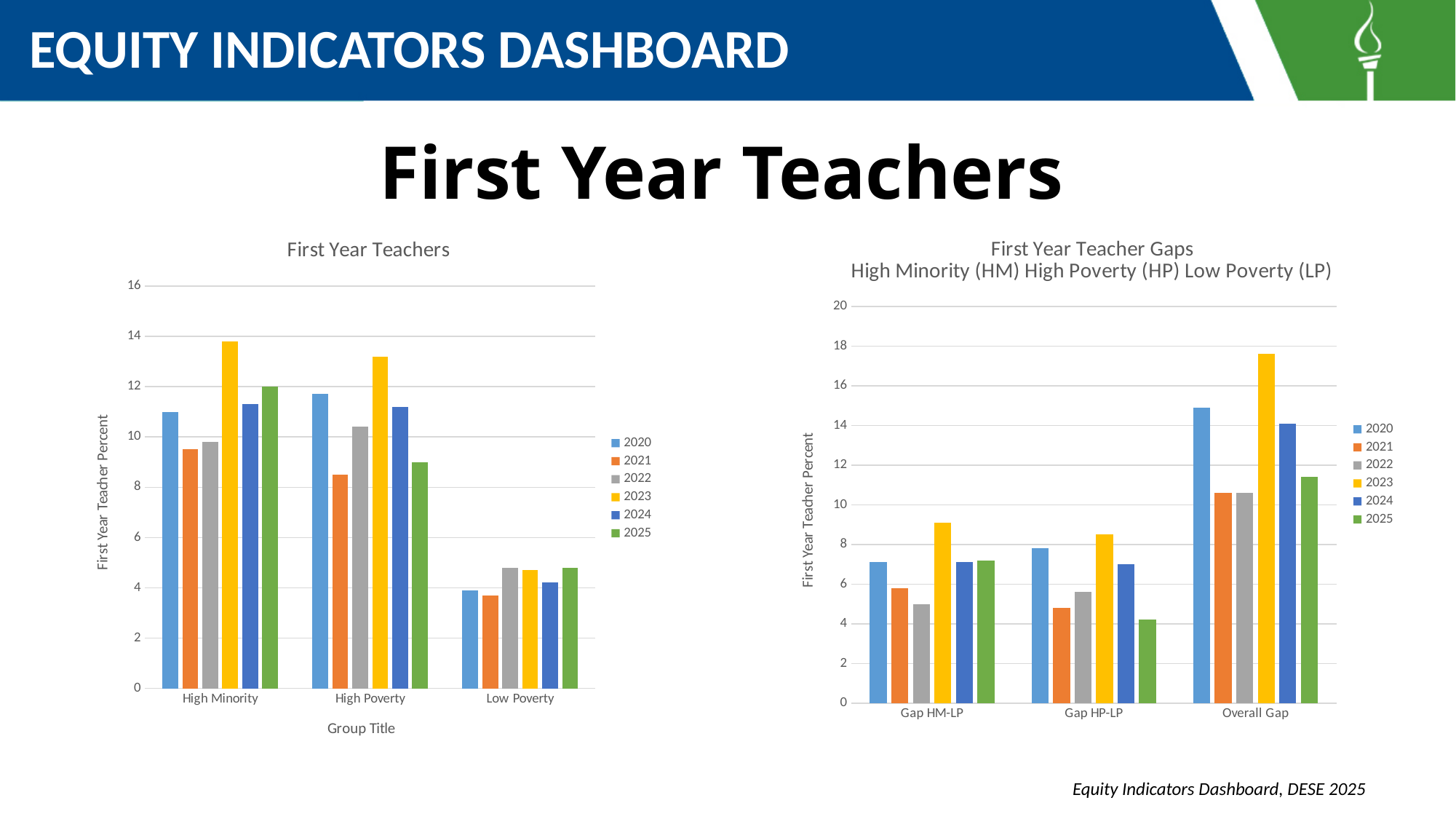
In the 'First Year Teacher Gaps' chart on the right, is the 2023 value for Overall Gap greater or less than 16? greater In the 'First Year Teacher Gaps' chart on the right, which year has the lowest bar for Gap HM-LP? 2022 What kind of chart is the 'First Year Teachers' chart on the left? bar chart In the 'First Year Teacher Gaps' chart on the right, how many categories are shown on the x axis? 3 In the 'First Year Teachers' chart on the left, which is larger for High Poverty: the 2020 value or the 2021 value? 2020 In the 'First Year Teachers' chart on the left, which year has the highest bar for High Minority? 2023 In the 'First Year Teachers' chart on the left, how many series does the legend list? 6 In the 'First Year Teachers' chart on the left, how many groups are shown on the x axis? 3 In the 'First Year Teacher Gaps' chart on the right, which category has the highest 2023 bar? Overall Gap What is the y-axis title of the 'First Year Teacher Gaps' chart on the right? First Year Teacher Percent In the 'First Year Teachers' chart on the left, is the 2023 value for High Minority greater or less than 12? greater In the 'First Year Teachers' chart on the left, is the 2021 value for Low Poverty greater or less than 4? less